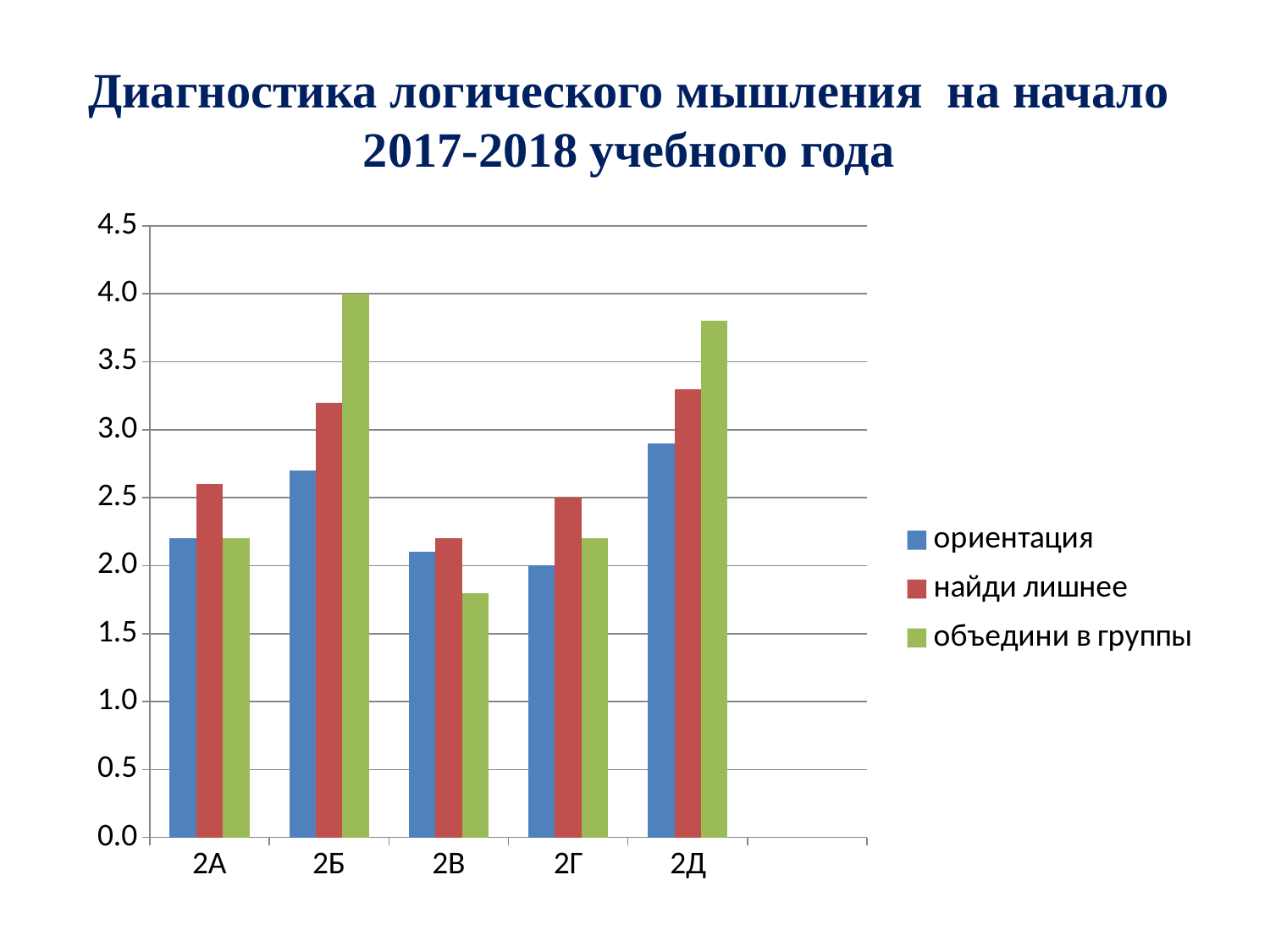
What is the value of 'объедини в группы' for class 2Б? 4.0 Which class has the lowest value for 'объедини в группы'? 2В What kind of chart is shown on the slide? bar chart Which class has the lowest value for 'найди лишнее'? 2В Which class has the highest value for 'объедини в группы'? 2Б Is the value of 'объедини в группы' for class 2В greater or less than 2.0? less How many classes (categories) are shown on the x axis? 5 For class 2А, which is larger: 'найди лишнее' or 'ориентация'? найди лишнее Which class has the highest value for 'ориентация'? 2Д What is the value of 'ориентация' for class 2Г? 2.0 How many series does the legend list? 3 Is the value of 'найди лишнее' for class 2Б greater or less than 3.0? greater